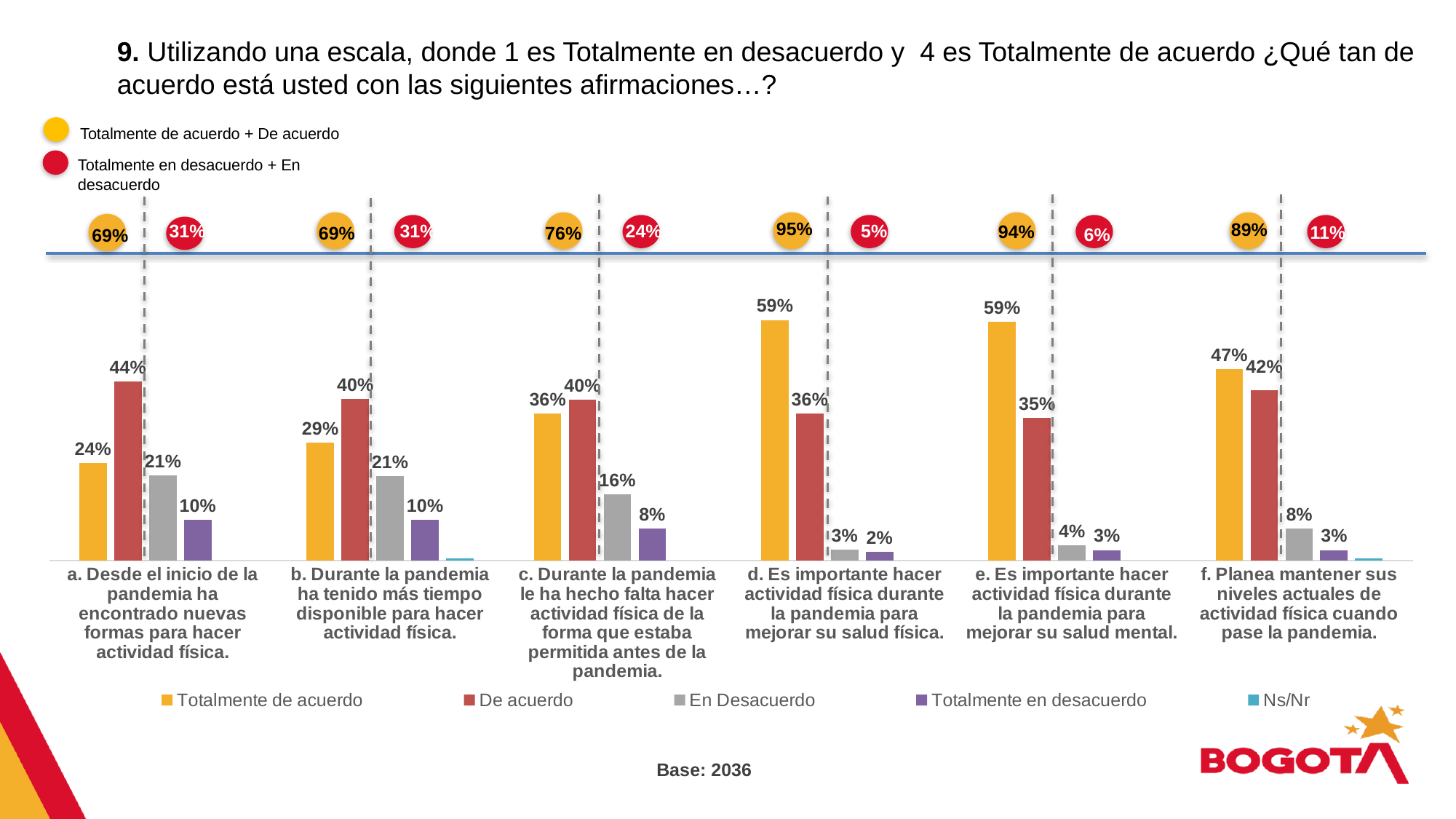
Which statement has the highest value for "De acuerdo"? a. Desde el inicio de la pandemia ha encontrado nuevas formas para hacer actividad física. How many series does the chart legend list? 5 What kind of chart is shown on the slide? Bar chart What is the value of "Totalmente de acuerdo" for statement a (Desde el inicio de la pandemia ha encontrado nuevas formas para hacer actividad física)? 24% What is the difference between "Totalmente de acuerdo" and "De acuerdo" for statement e (Es importante hacer actividad física durante la pandemia para mejorar su salud mental)? 24% What is the value of "Totalmente en desacuerdo" for statement d (Es importante hacer actividad física durante la pandemia para mejorar su salud física)? 2% What is the value of "De acuerdo" for statement c (Durante la pandemia le ha hecho falta hacer actividad física...)? 40% What is the value of "En Desacuerdo" for statement f (Planea mantener sus niveles actuales de actividad física cuando pase la pandemia)? 8% For statement b (Durante la pandemia ha tenido más tiempo disponible para hacer actividad física), which is larger: "Totalmente de acuerdo" or "De acuerdo"? De acuerdo Which statement has the lowest value for "Totalmente de acuerdo"? a. Desde el inicio de la pandemia ha encontrado nuevas formas para hacer actividad física. What combined percentage of "Totalmente de acuerdo + De acuerdo" is shown in the yellow circle above statement d? 95% How many statements (categories) are shown on the x axis of the chart? 6